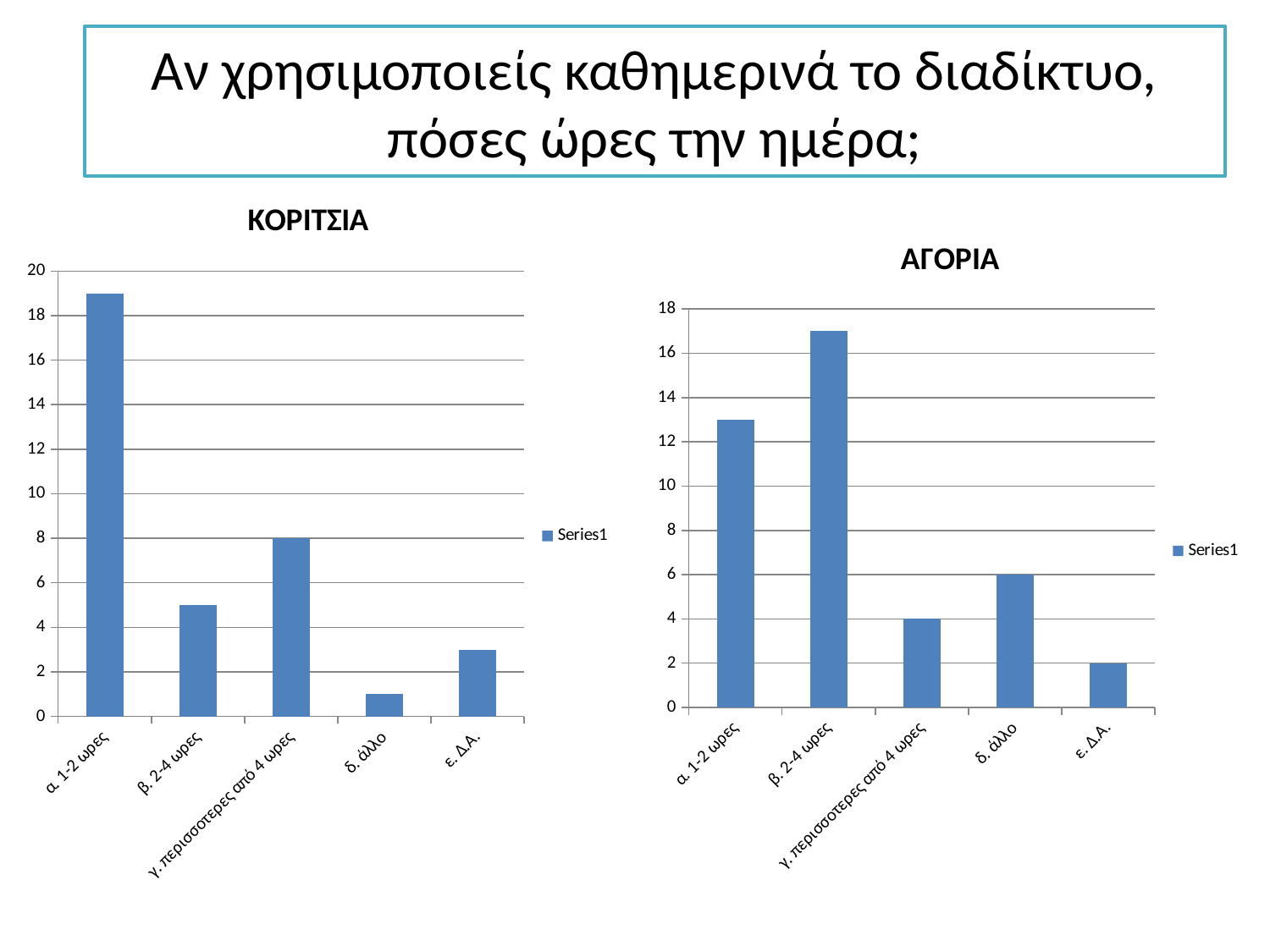
In the ΚΟΡΙΤΣΙΑ chart, which category has the highest value? α. 1-2 ωρες In the ΑΓΟΡΙΑ chart, which is larger, the value for α. 1-2 ωρες or the value for β. 2-4 ωρες? β. 2-4 ωρες In the ΑΓΟΡΙΑ chart, which category has the lowest value? ε. Δ.Α. In the ΚΟΡΙΤΣΙΑ chart, what is the value for γ. περισσοτερες από 4 ωρες? 8 In the ΚΟΡΙΤΣΙΑ chart, is the value for α. 1-2 ωρες greater or less than 18? greater How many categories are shown in the ΚΟΡΙΤΣΙΑ chart? 5 In the ΑΓΟΡΙΑ chart, what is the value for ε. Δ.Α.? 2 In the ΚΟΡΙΤΣΙΑ chart, which category has the lowest value? δ. άλλο In the ΑΓΟΡΙΑ chart, what is the value for δ. άλλο? 6 In the ΑΓΟΡΙΑ chart, is the value for α. 1-2 ωρες greater or less than 14? less In the ΑΓΟΡΙΑ chart, what is the value for γ. περισσοτερες από 4 ωρες? 4 In the ΑΓΟΡΙΑ chart, which category has the highest value? β. 2-4 ωρες